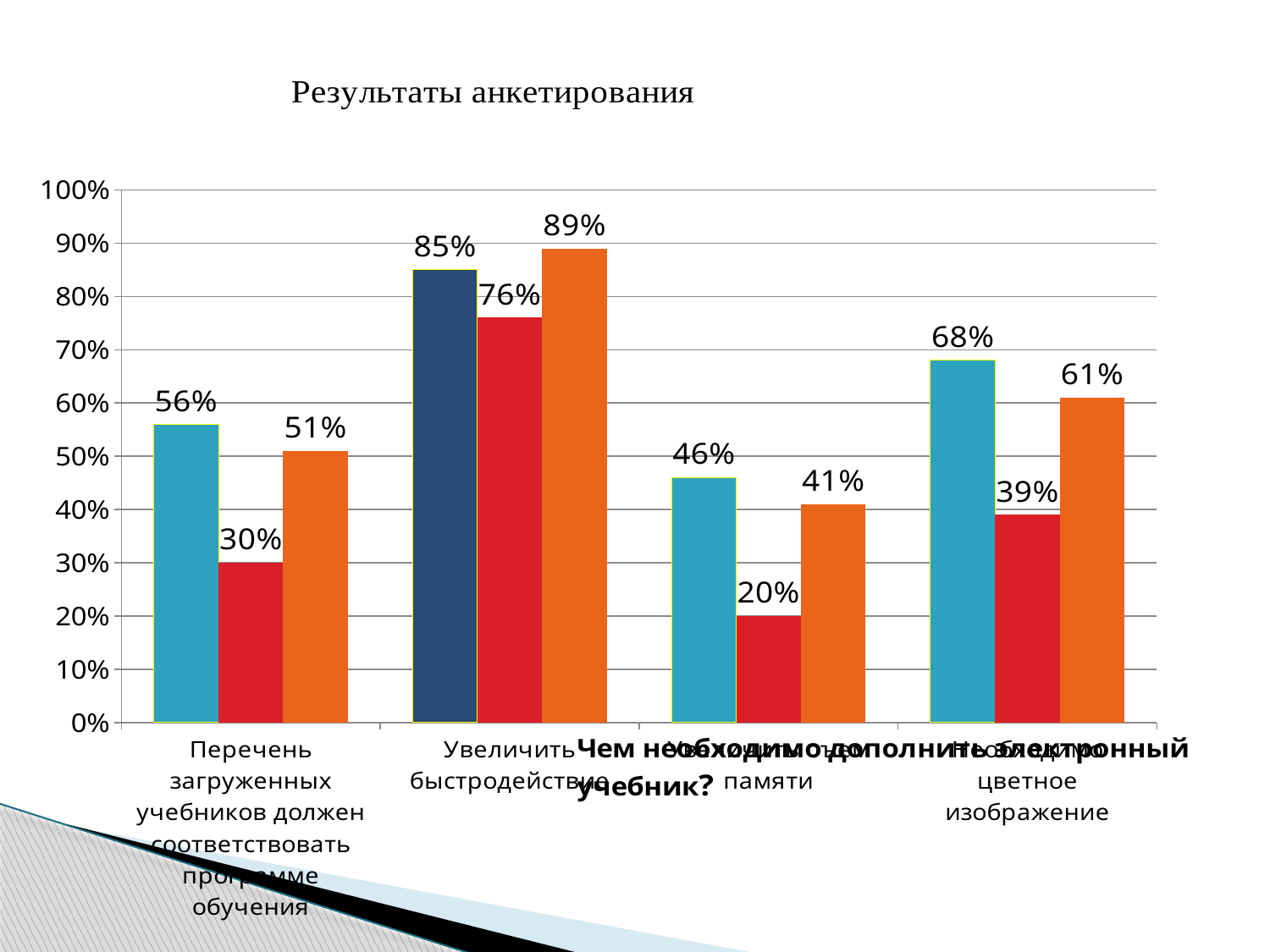
What is the value of the first (blue) bar for the category 'цветное изображение'? 68% What is the title of the slide above the chart? Результаты анкетирования What is the difference between the blue bar (56%) and the orange bar (51%) in the first category? 5% What type of chart is shown on the slide? bar chart What is the value of the orange bar for the category 'Увеличить быстродействие'? 89% What is the difference between the orange bar (89%) and the red bar (76%) for 'Увеличить быстродействие'? 13% Which category has the highest orange bar? Увеличить быстродействие What is the value of the red bar in the third category group? 20% For the category 'цветное изображение', which is larger: the blue bar or the orange bar? the blue bar (68%) What is the value of the red bar for the category 'Перечень загруженных учебников должен соответствовать программе обучения'? 30% Which category has the lowest red bar? the third category (20%) How many categories are shown along the x axis of the chart? 4